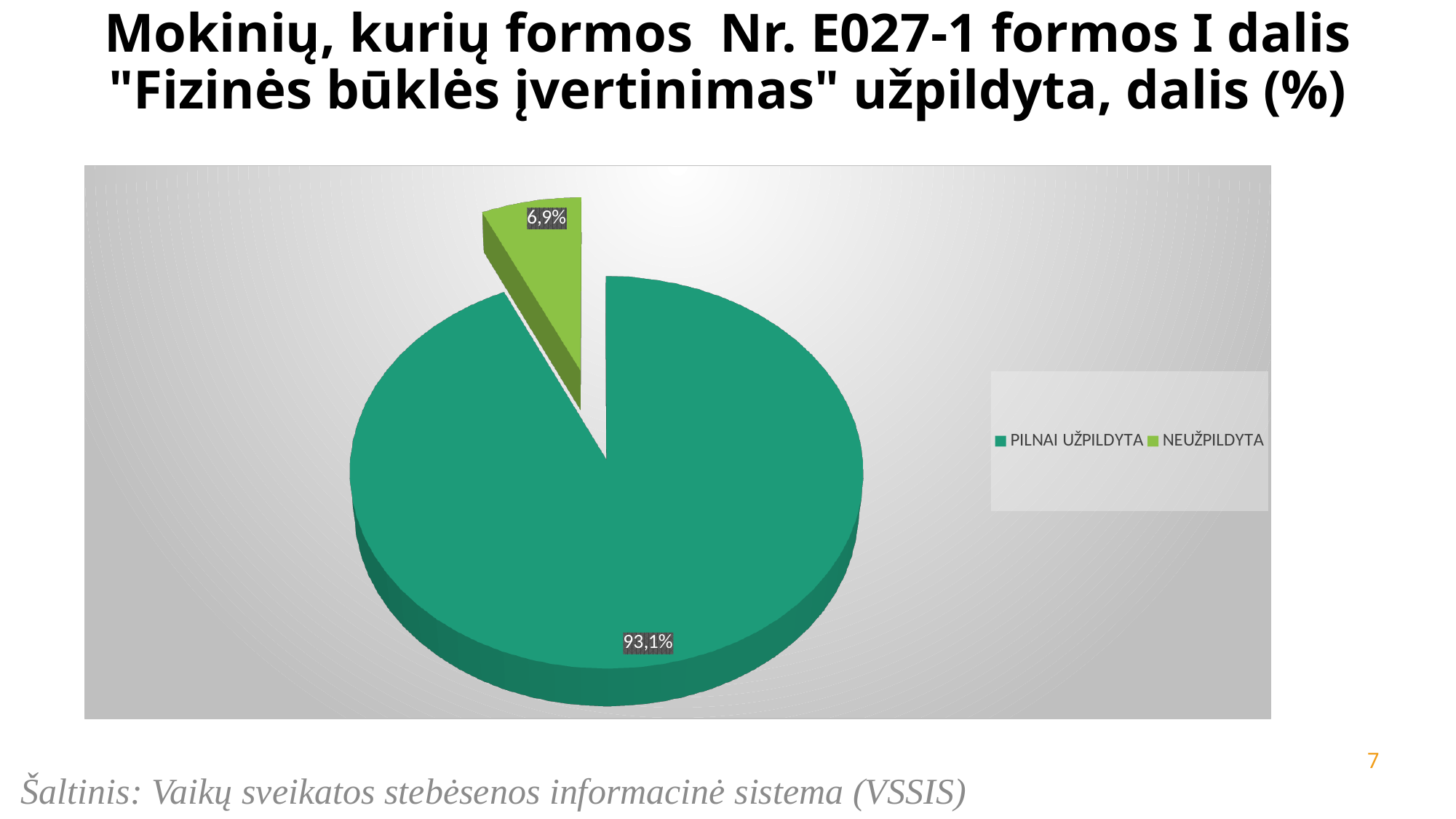
Which slice is the smallest? NEUŽPILDYTA What kind of chart is shown on the slide? pie chart What colour is the NEUŽPILDYTA slice? green What is the source cited below the chart? Vaikų sveikatos stebėsenos informacinė sistema (VSSIS) What share of the pie does PILNAI UŽPILDYTA represent? 93,1% What share of the pie does NEUŽPILDYTA represent? 6,9% How many slices does the pie chart have? 2 Which is larger, PILNAI UŽPILDYTA or NEUŽPILDYTA? PILNAI UŽPILDYTA How many entries does the legend list? 2 Which slice is the largest? PILNAI UŽPILDYTA What is the difference in percentage points between PILNAI UŽPILDYTA and NEUŽPILDYTA? 86,2